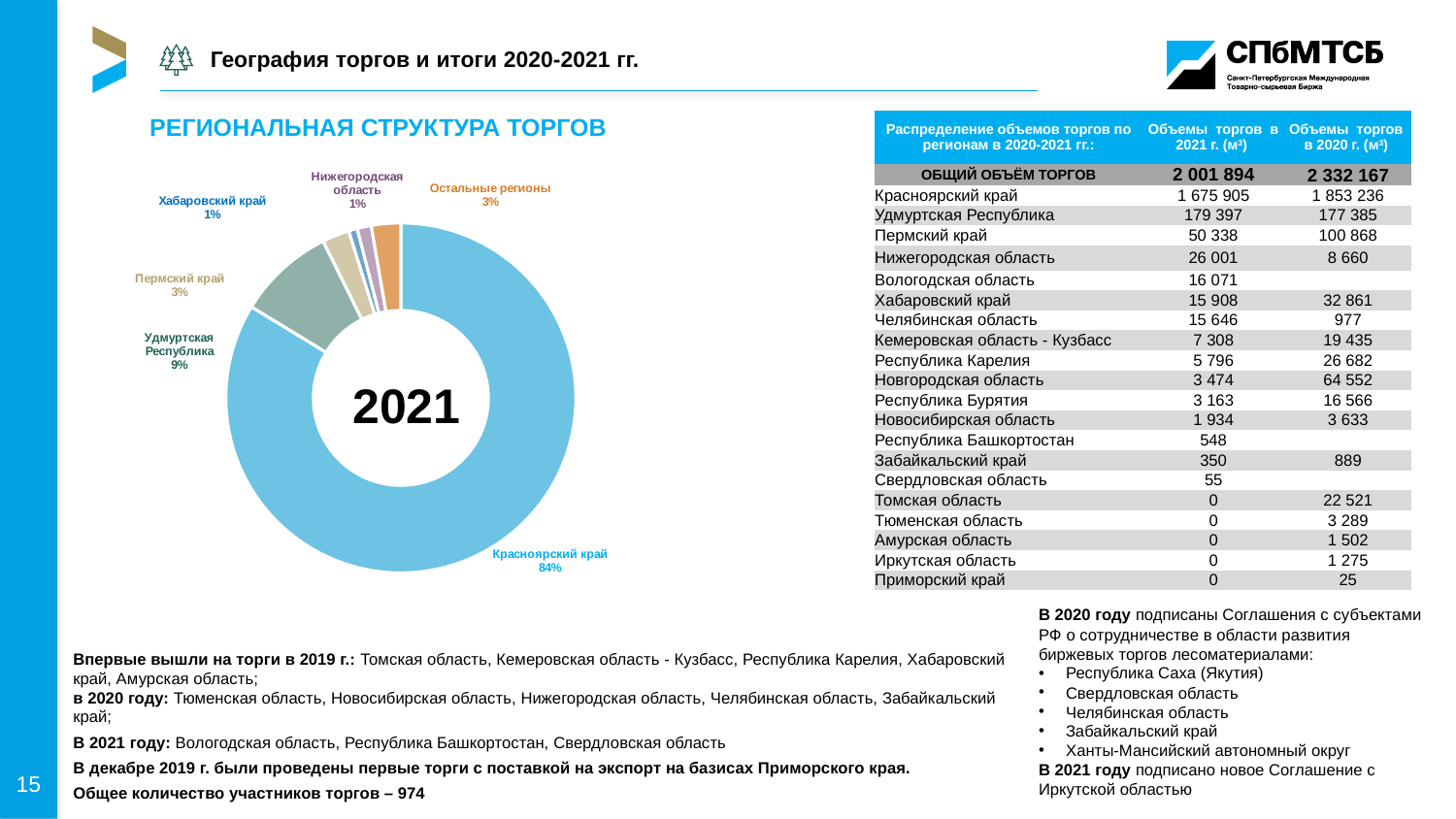
What percentage is shown for Нижегородская область in the doughnut chart? 1% What type of chart is shown on the left of the slide? Doughnut chart Which region has the largest slice in the doughnut chart? Красноярский край Which is larger in the doughnut chart: the slice for Удмуртская Республика or the slice for Пермский край? Удмуртская Республика What share is labelled for Остальные регионы in the doughnut chart? 3% What percentage is shown for Пермский край in the doughnut chart? 3% What is the difference in percentage points between the Красноярский край slice and the Удмуртская Республика slice? 75 What share of the doughnut chart does Красноярский край account for? 84% What is the value shown for Удмуртская Республика in the doughnut chart? 9% How many labelled slices does the doughnut chart have? 6 What percentage is shown for Хабаровский край in the doughnut chart? 1% What year is written in the centre of the doughnut chart? 2021